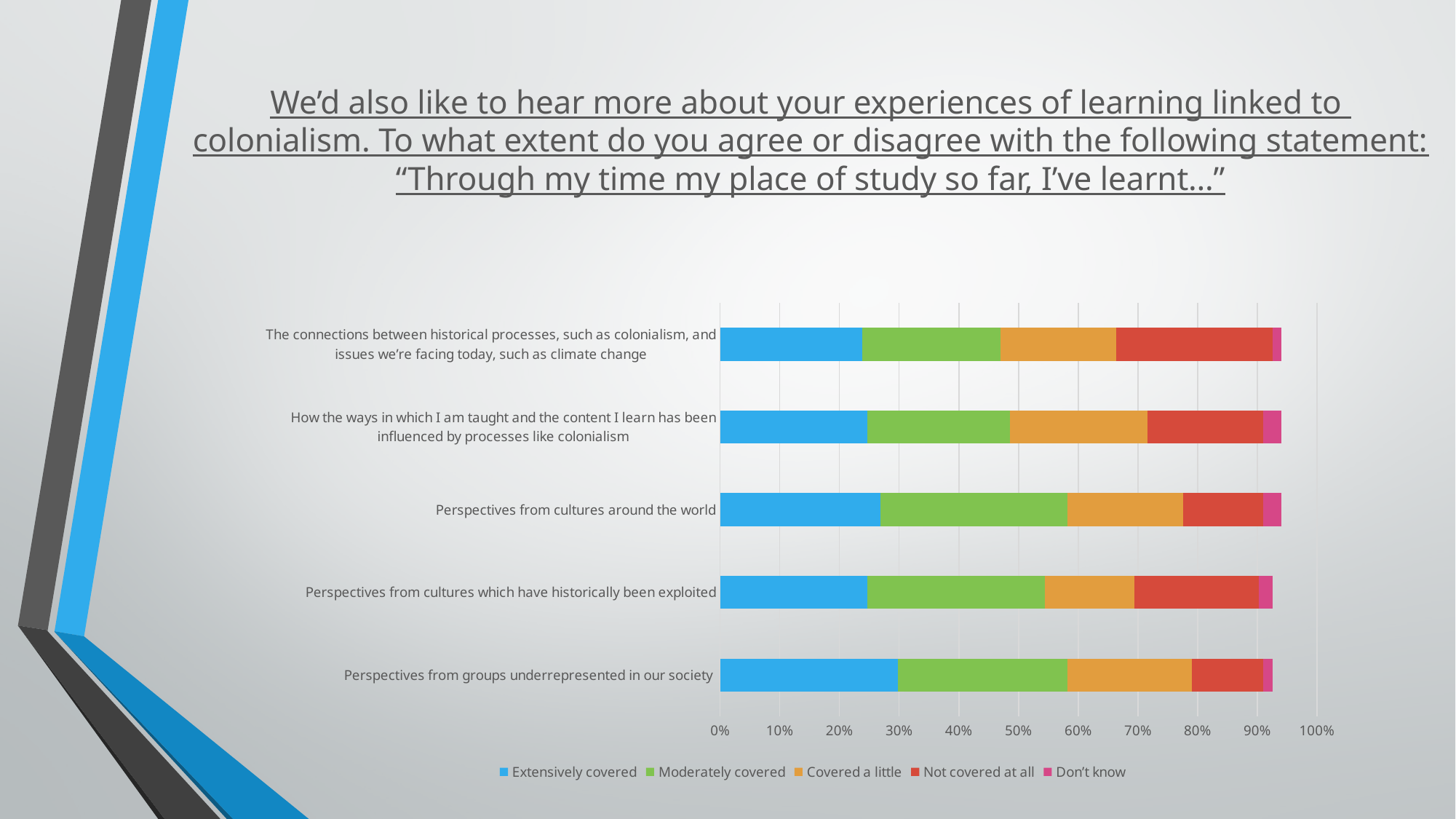
Is the 'Extensively covered' share for 'The connections between historical processes, such as colonialism, and issues we're facing today, such as climate change' greater or less than 30%? less Which statement has the largest 'Not covered at all' segment? The connections between historical processes, such as colonialism, and issues we're facing today, such as climate change How many statements (categories) are plotted on the chart? 5 Is the 'Extensively covered' share for 'Perspectives from groups underrepresented in our society' greater or less than 40%? less What kind of chart is shown on the slide? Stacked bar chart Is the 'Extensively covered' share for 'Perspectives from groups underrepresented in our society' greater or less than 20%? greater What is the highest value shown on the horizontal axis? 100% Which statement has the largest 'Extensively covered' segment? Perspectives from groups underrepresented in our society Which has the larger 'Extensively covered' segment: 'Perspectives from groups underrepresented in our society' or 'The connections between historical processes, such as colonialism, and issues we're facing today, such as climate change'? Perspectives from groups underrepresented in our society Which response option is listed first in the legend? Extensively covered How many series does the legend list? 5 What colour represents 'Don't know' in the chart? Pink